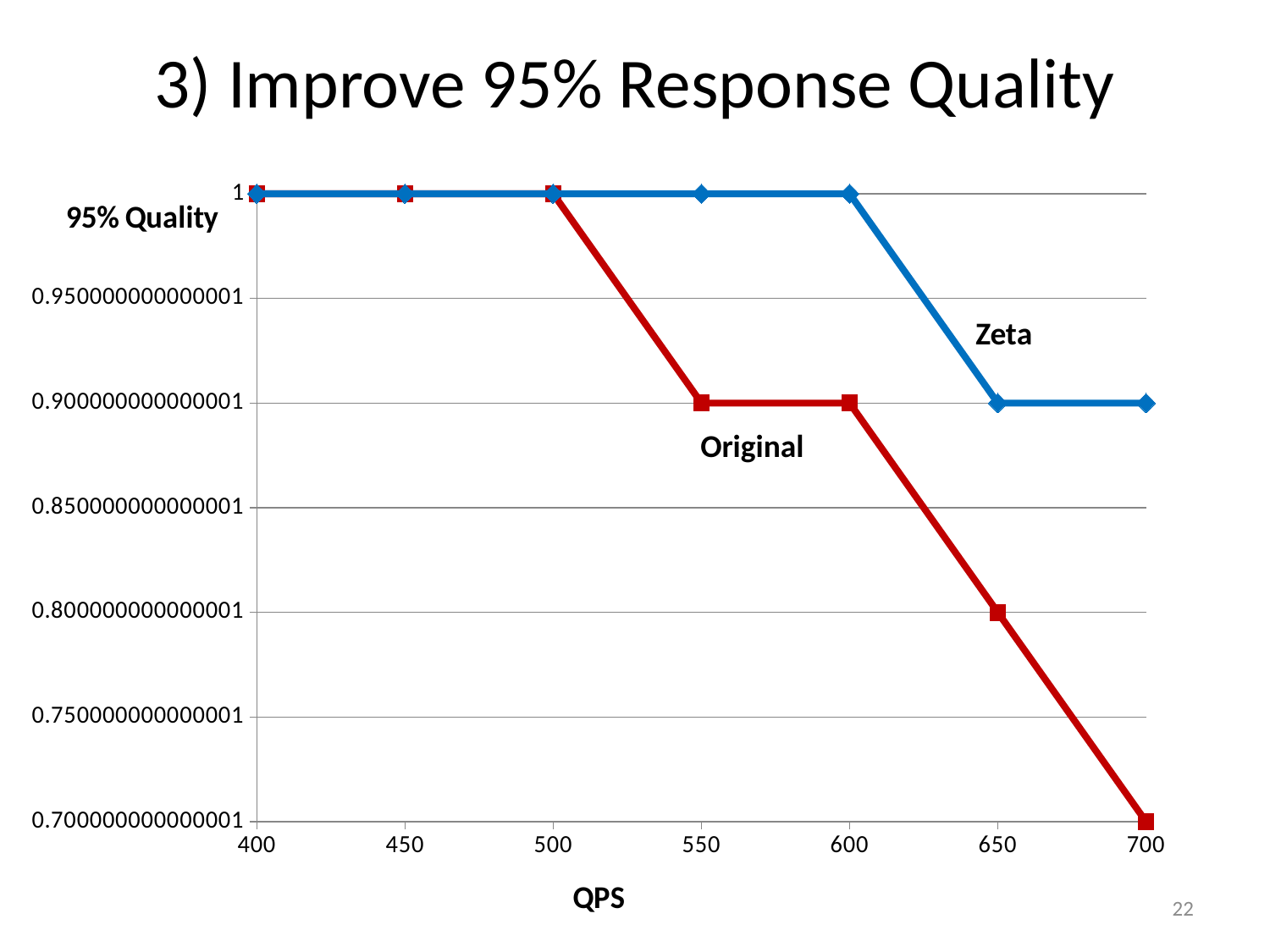
How many QPS values are plotted along the x axis? 7 At 550 QPS, which series has the higher 95% Quality, Zeta or Original? Zeta Is the 95% Quality value for Original at 700 QPS greater or less than 0.75? less What is the 95% Quality value for Zeta at 600 QPS? 1 Is the 95% Quality value for Zeta at 650 QPS greater or less than 0.95? less How many data series are plotted on the chart? 2 What is the 95% Quality value for Original at 500 QPS? 1 At which QPS value does the Original series reach its lowest 95% Quality? 700 Does the Original series rise or fall as QPS increases from 500 to 700? fall At 650 QPS, which series has the higher 95% Quality, Zeta or Original? Zeta What kind of chart is shown on the slide? line chart Is the 95% Quality value for Original at 550 QPS greater or less than 0.85? greater